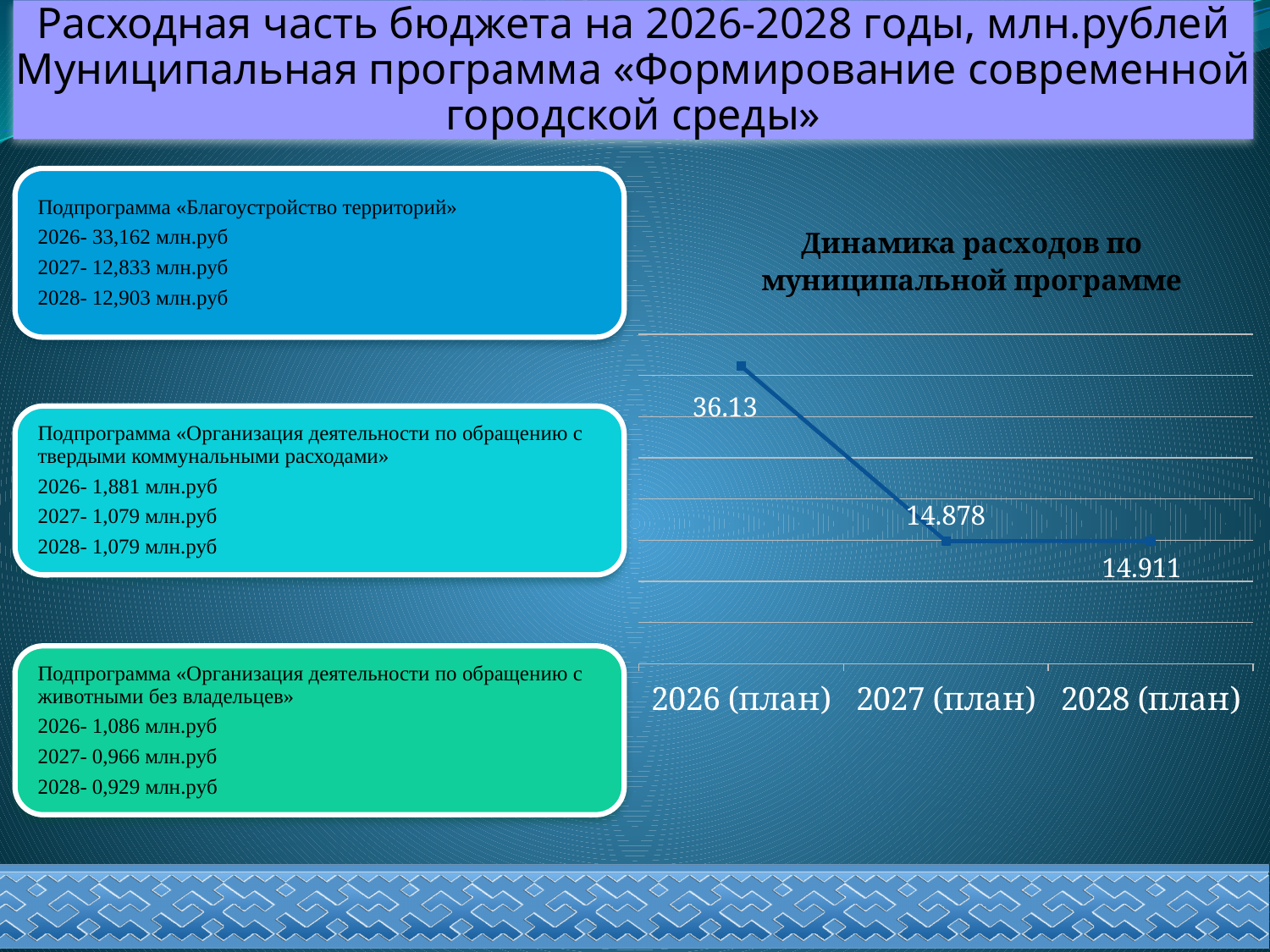
Which is larger, the value for 2027 (план) or the value for 2028 (план)? 2028 (план) What type of chart is shown on the slide? Line chart What is the value for 2027 (план) in the chart? 14.878 What is the value for 2026 (план) in the chart? 36.13 Does the value rise or fall from 2026 (план) to 2027 (план)? Fall Which year has the highest value in the chart? 2026 (план) What is the difference between the values for 2026 (план) and 2027 (план)? 21.252 Which year has the lowest value in the chart? 2027 (план) What is the title of the chart? Динамика расходов по муниципальной программе What is the difference between the values for 2028 (план) and 2027 (план)? 0.033 How many data points are plotted in the chart? 3 What is the value for 2028 (план) in the chart? 14.911